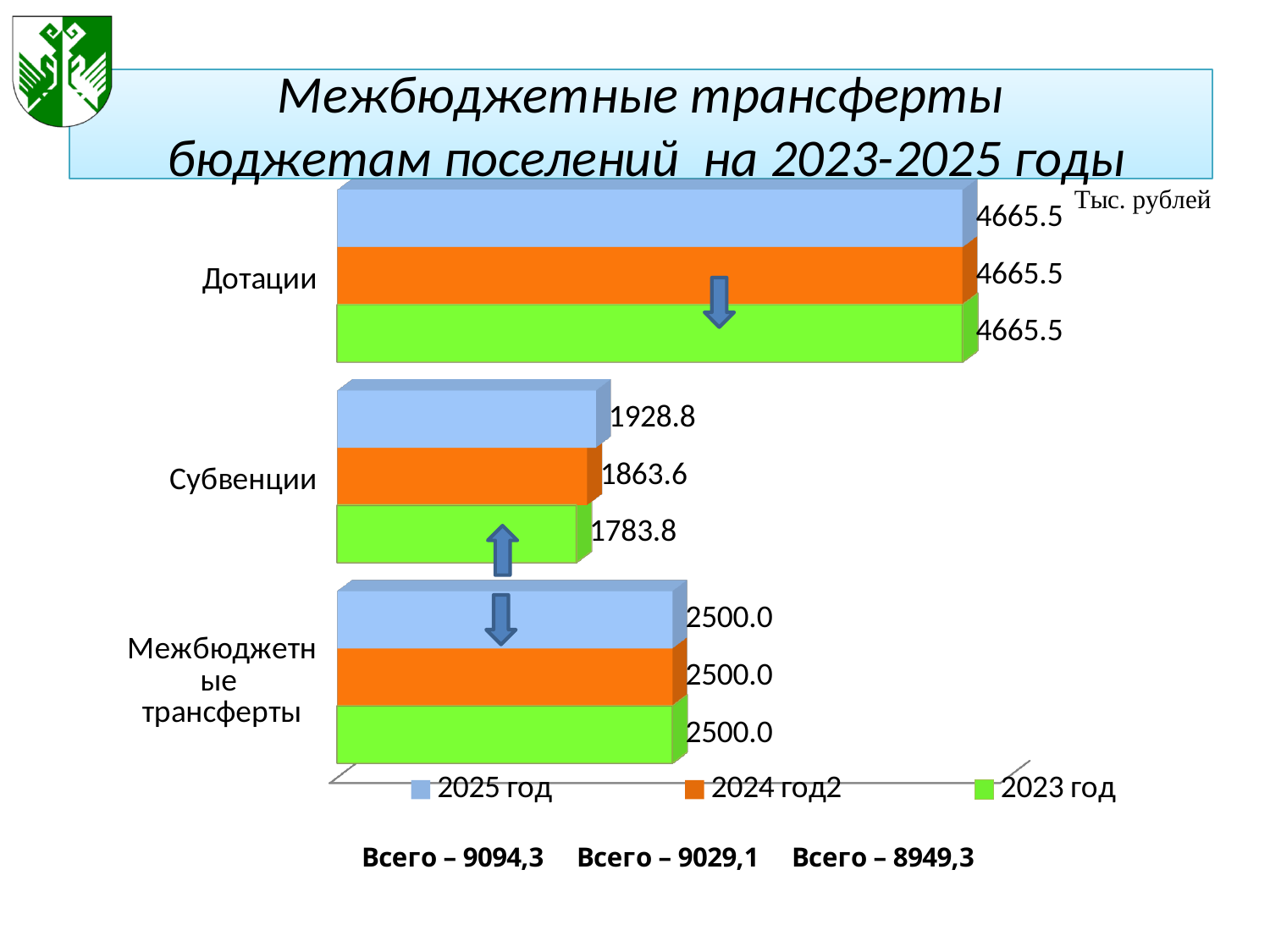
How many categories are shown on the chart? 3 What unit is indicated in the top right corner of the chart? Тыс. рублей What is the value for Межбюджетные трансферты in the 2025 год series? 2500.0 Which category has the highest value in the 2023 год series? Дотации What type of chart is shown on the slide? bar chart How many series does the legend list? 3 What is the value for Дотации in the 2024 год2 series? 4665.5 What is the difference between the 2025 год and 2023 год values for Субвенции? 145.0 What is the value for Субвенции in the 2025 год series? 1928.8 Which is larger for Субвенции: the 2024 год2 value or the 2023 год value? 2024 год2 What is the value for Субвенции in the 2023 год series? 1783.8 Which category has the lowest value in the 2025 год series? Субвенции